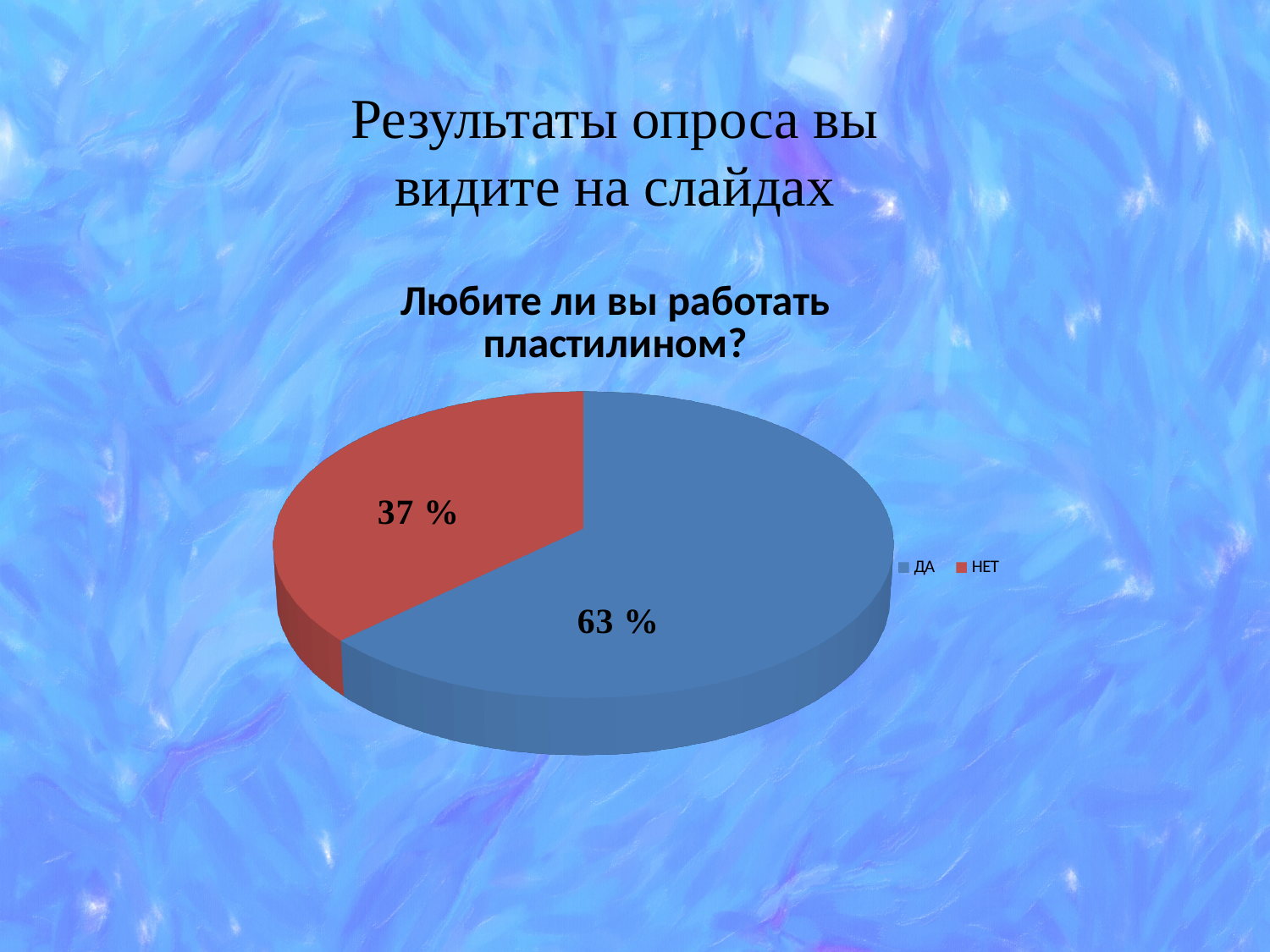
Which slice is the largest? ДА How many entries does the legend list? 2 What is the title of the chart? Любите ли вы работать пластилином? What share of the pie does the НЕТ slice take? 37 % What share of the pie does the ДА slice take? 63 % Which is larger, the ДА slice or the НЕТ slice? ДА What colour is the ДА slice? blue What kind of chart is shown on the slide? pie chart Which slice is the smallest? НЕТ What is the difference between the ДА and НЕТ shares? 26 % How many slices does the pie chart have? 2